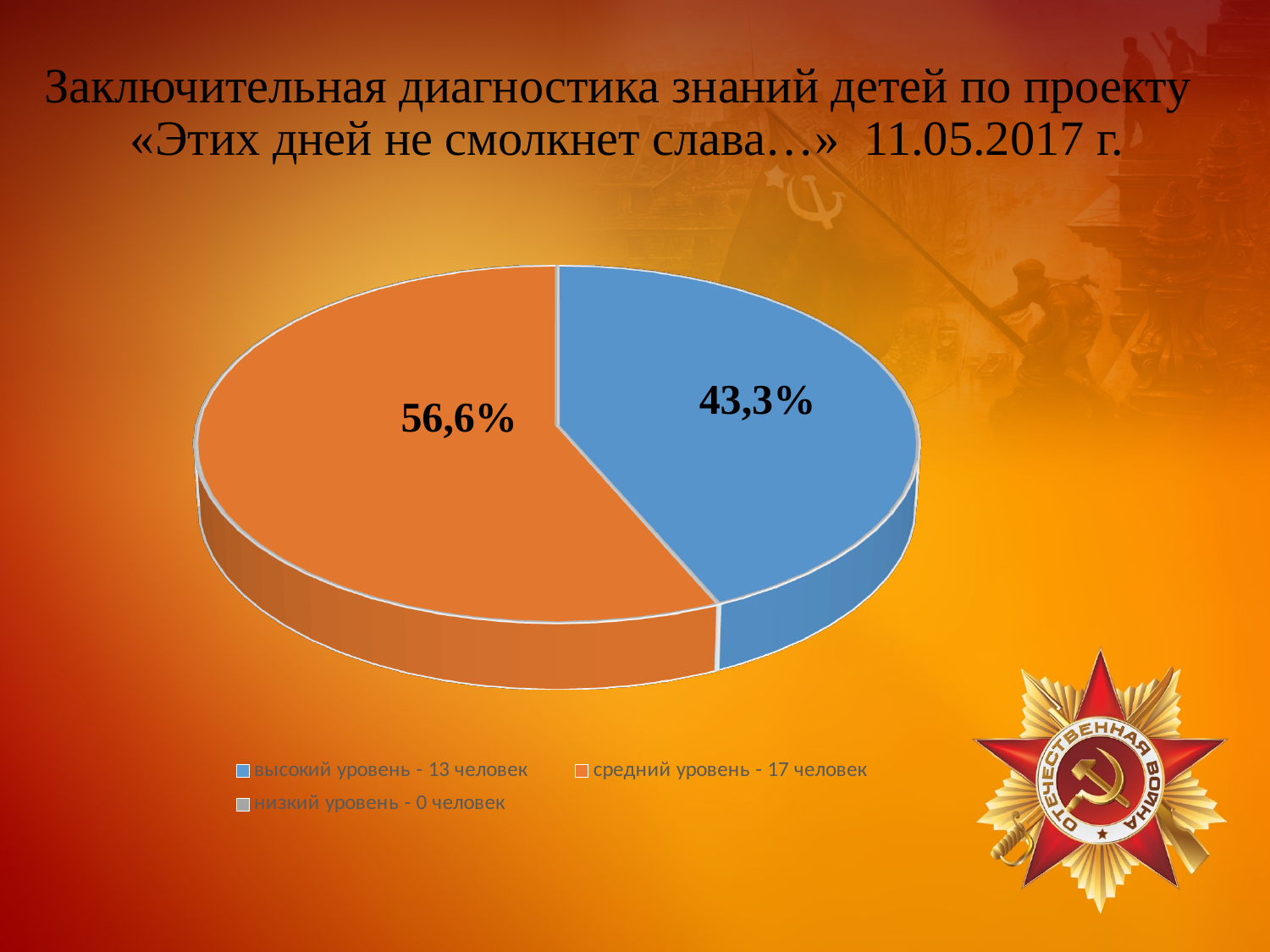
Is the share of the средний уровень slice greater or less than 50%? greater How many entries does the legend list? 3 How many children are in the высокий уровень category according to the legend? 13 How many children are in the низкий уровень category according to the legend? 0 What is the difference in percentage points between the средний уровень slice and the высокий уровень slice? 13,3 What kind of chart is shown on the slide? pie chart What date is given in the slide title? 11.05.2017 г. What percentage is shown for the slice labelled "средний уровень - 17 человек"? 56,6% Which of the two visible slices is smaller, высокий уровень or средний уровень? высокий уровень What colour is the slice for высокий уровень? blue Which category has the largest slice of the pie? средний уровень - 17 человек What percentage is shown for the slice labelled "высокий уровень - 13 человек"? 43,3%